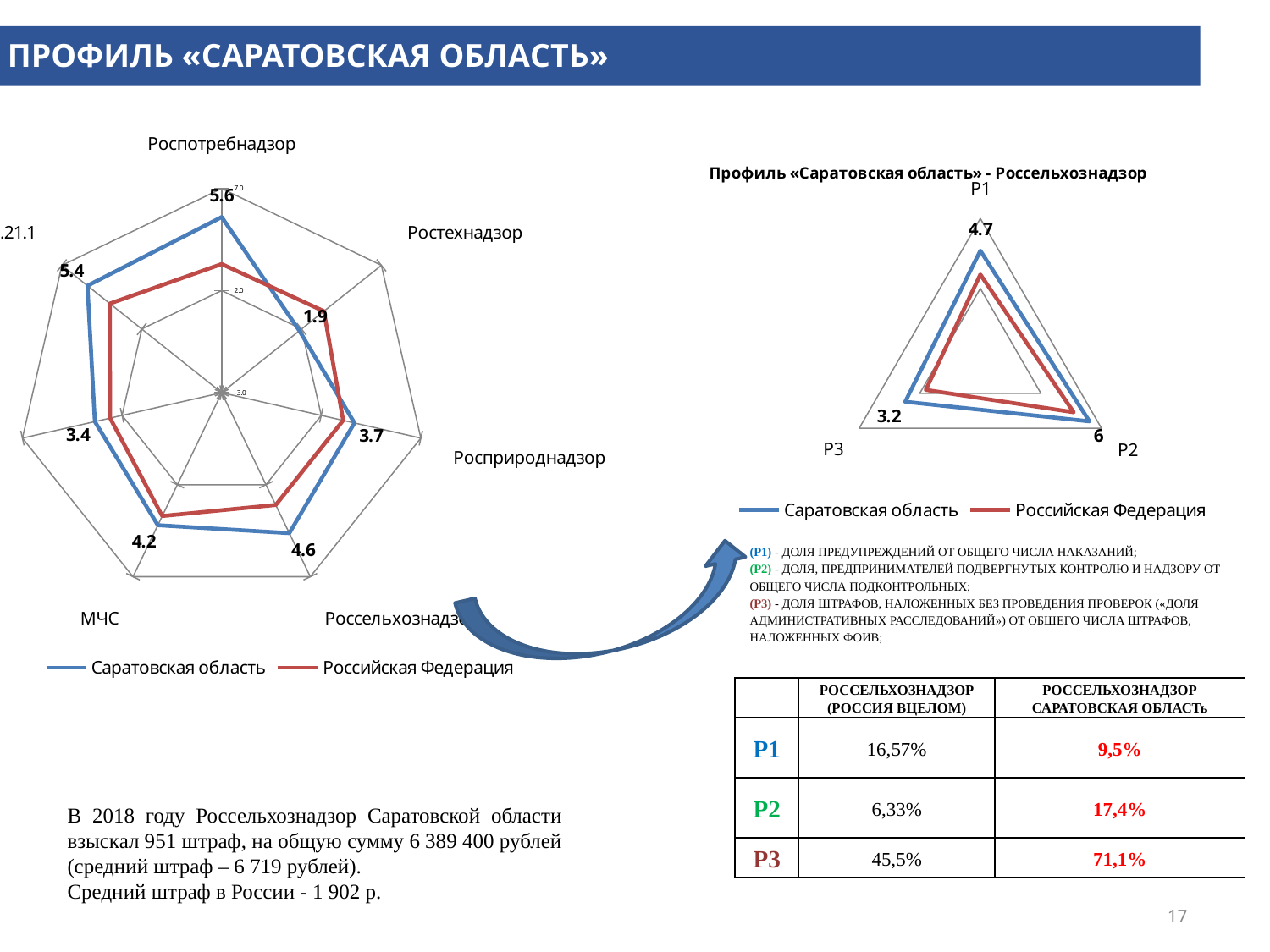
In the left radar chart, what is the value for Саратовская область on the Росприроднадзор axis? 3.7 In the chart titled «Профиль «Саратовская область» - Россельхознадзор», what is the difference between the Саратовская область values at P2 and P3? 2.8 In the left radar chart, what is the difference between the Саратовская область values for Роспотребнадзор and Ростехнадзор? 3.7 In the left radar chart, what is the value for Саратовская область on the МЧС axis? 4.2 What kind of chart is the left chart on the slide? Radar chart How many series does the legend of the left radar chart list? 2 In the left radar chart, which series has the larger value on the Ростехнадзор axis, Саратовская область or Российская Федерация? Российская Федерация How many axes (categories) does the chart titled «Профиль «Саратовская область» - Россельхознадзор» have? 3 In the left radar chart, what is the value for Саратовская область on the Роспотребнадзор axis? 5.6 In the left radar chart, what is the value for Саратовская область on the Ростехнадзор axis? 1.9 In the chart titled «Профиль «Саратовская область» - Россельхознадзор», on which axis does Саратовская область have its lowest value? P3 In the chart titled «Профиль «Саратовская область» - Россельхознадзор», what is the value for Саратовская область at P2? 6